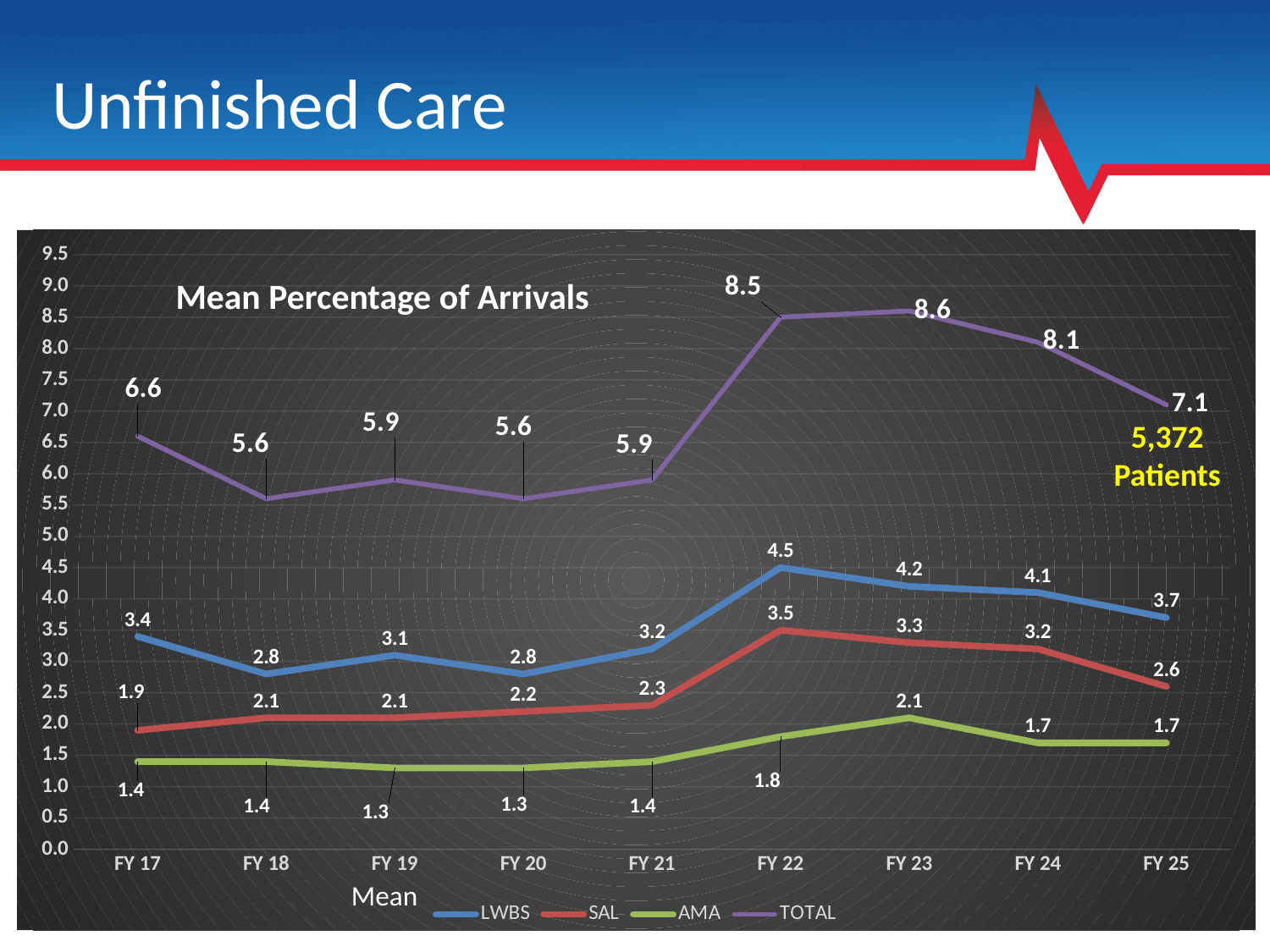
What type of chart is shown on the slide? line chart What is the AMA value for FY 19? 1.3 Does the TOTAL series rise or fall from FY 23 to FY 25? fall What is the difference between the TOTAL values for FY 22 and FY 21? 2.6 What is the TOTAL value for FY 23? 8.6 What is the LWBS value for FY 22? 4.5 In which fiscal year is the SAL series lowest? FY 17 How many fiscal years are plotted on the x axis? 9 What is the SAL value for FY 25? 2.6 Which is larger, the LWBS value for FY 17 or the LWBS value for FY 18? FY 17 In which fiscal year is the TOTAL series highest? FY 23 How many series does the legend list? 4